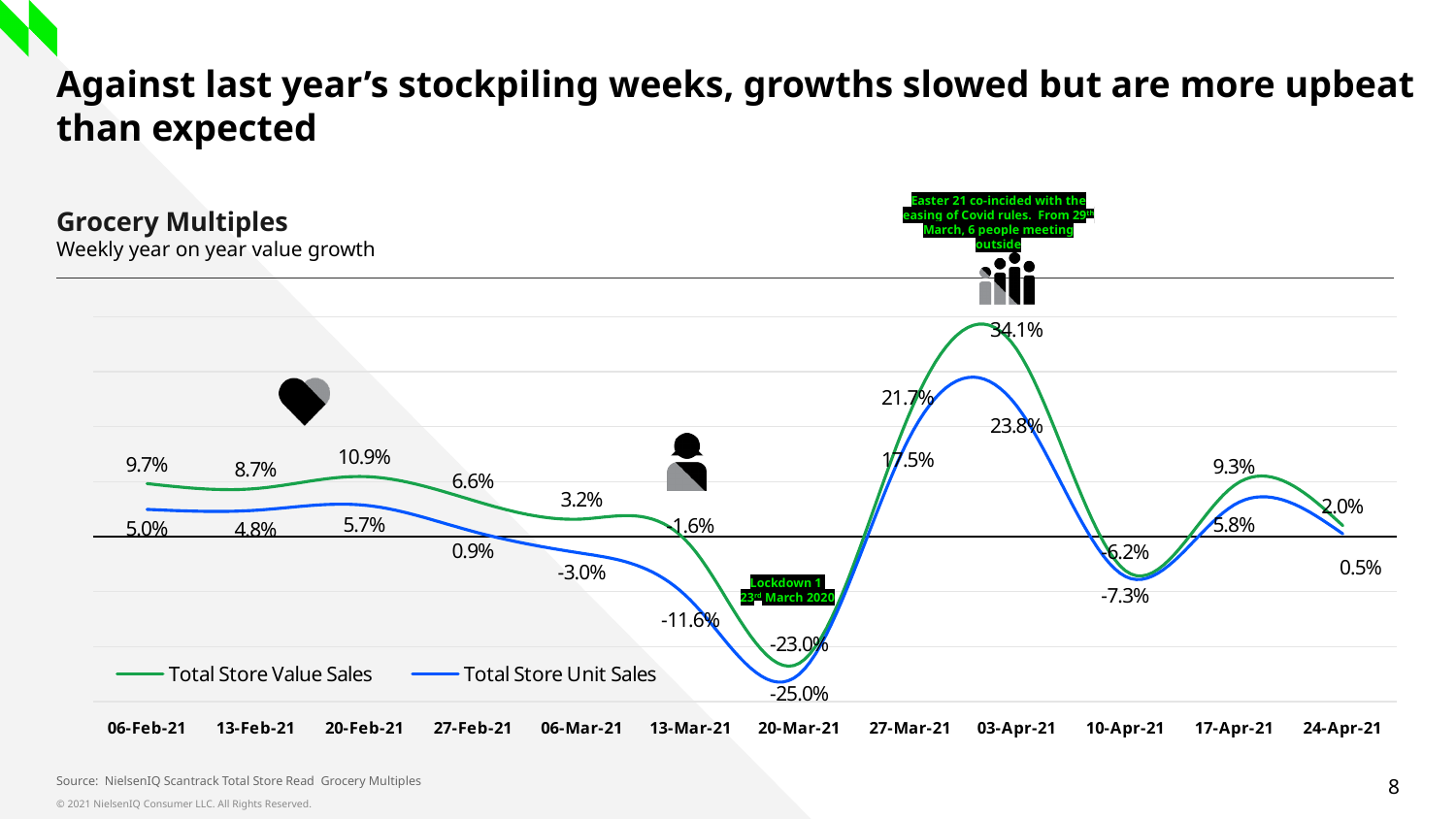
What kind of chart is shown on the slide? Line chart How many series does the legend list? 2 What is the Total Store Unit Sales growth for the week of 27-Feb-21? 0.9% In which week is Total Store Unit Sales growth lowest? 20-Mar-21 Does Total Store Value Sales growth rise or fall from 20-Mar-21 to 03-Apr-21? Rise What is the Total Store Unit Sales growth for the week of 20-Mar-21? -25.0% How many weeks are plotted on the x axis? 12 For the week of 03-Apr-21, how much higher is Total Store Value Sales growth than Total Store Unit Sales growth? 10.3 percentage points What is the Total Store Value Sales growth for the week of 10-Apr-21? -6.2% What is the Total Store Value Sales growth for the week of 03-Apr-21? 34.1% In which week is Total Store Value Sales growth highest? 03-Apr-21 For the week of 20-Feb-21, which series has the higher growth, Total Store Value Sales or Total Store Unit Sales? Total Store Value Sales